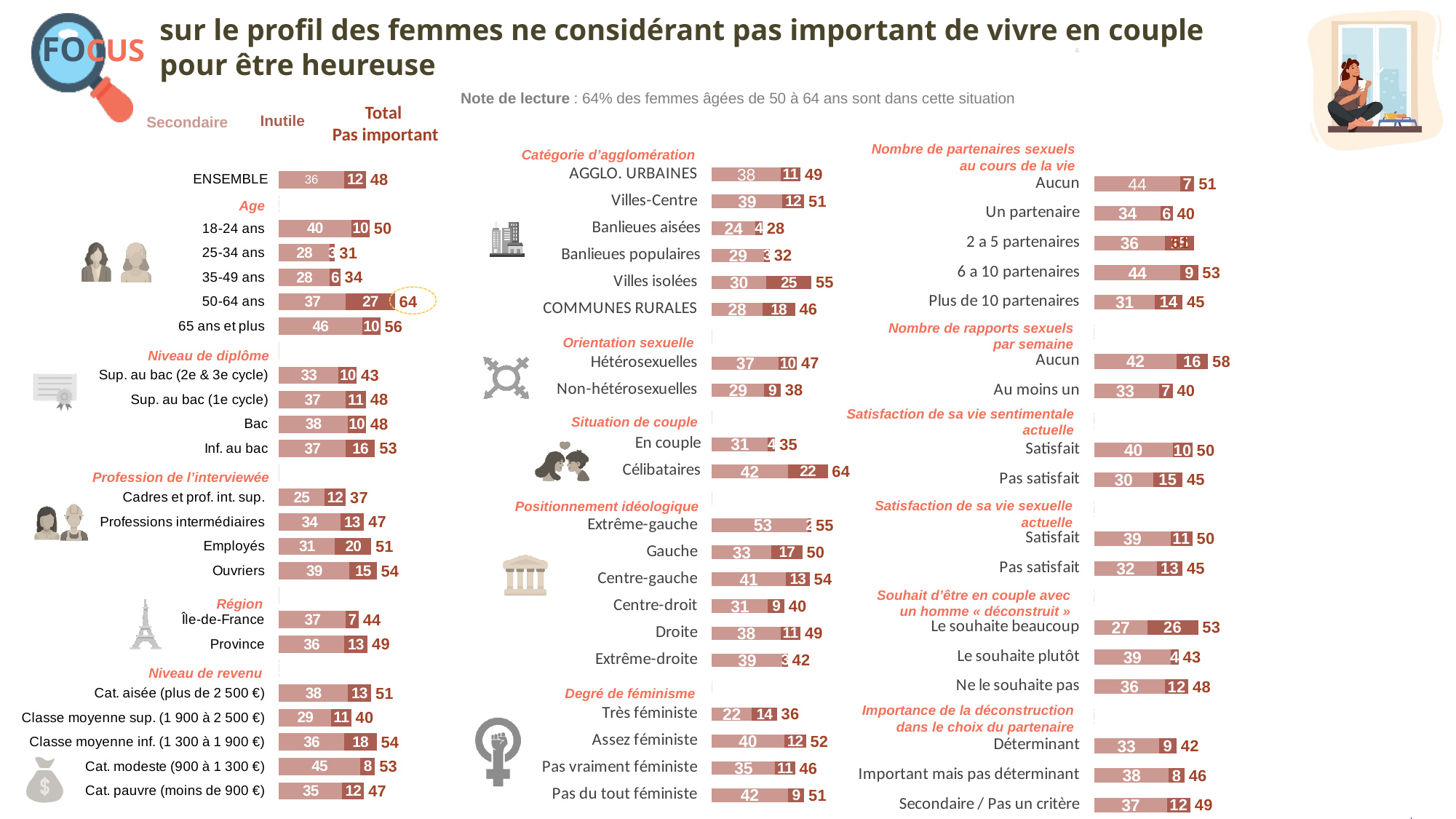
In the Age chart, which age group has the highest Total Pas important value? 50-64 ans In the Situation de couple chart, what is the Inutile value for Célibataires? 22 In the Situation de couple chart, what is the difference between the Total Pas important values for Célibataires and En couple? 29 In the Positionnement idéologique chart, what is the Secondaire value for Extrême-gauche? 53 In the Profession de l'interviewée chart, how many categories are shown? 4 In the Age chart, which age group has the lowest Total Pas important value? 25-34 ans In the Age chart, what is the Total Pas important value for 50-64 ans? 64 In the Catégorie d'agglomération chart, which category has the lowest Total Pas important value? Banlieues aisées In the Souhait d'être en couple avec un homme « déconstruit » chart, what is the Inutile value for Le souhaite beaucoup? 26 In the Degré de féminisme chart, which is larger: the Total Pas important for Assez féministe or for Très féministe? Assez féministe In the Nombre de rapports sexuels par semaine chart, what is the Total Pas important value for Aucun? 58 What kind of chart is used throughout the slide? Stacked bar chart